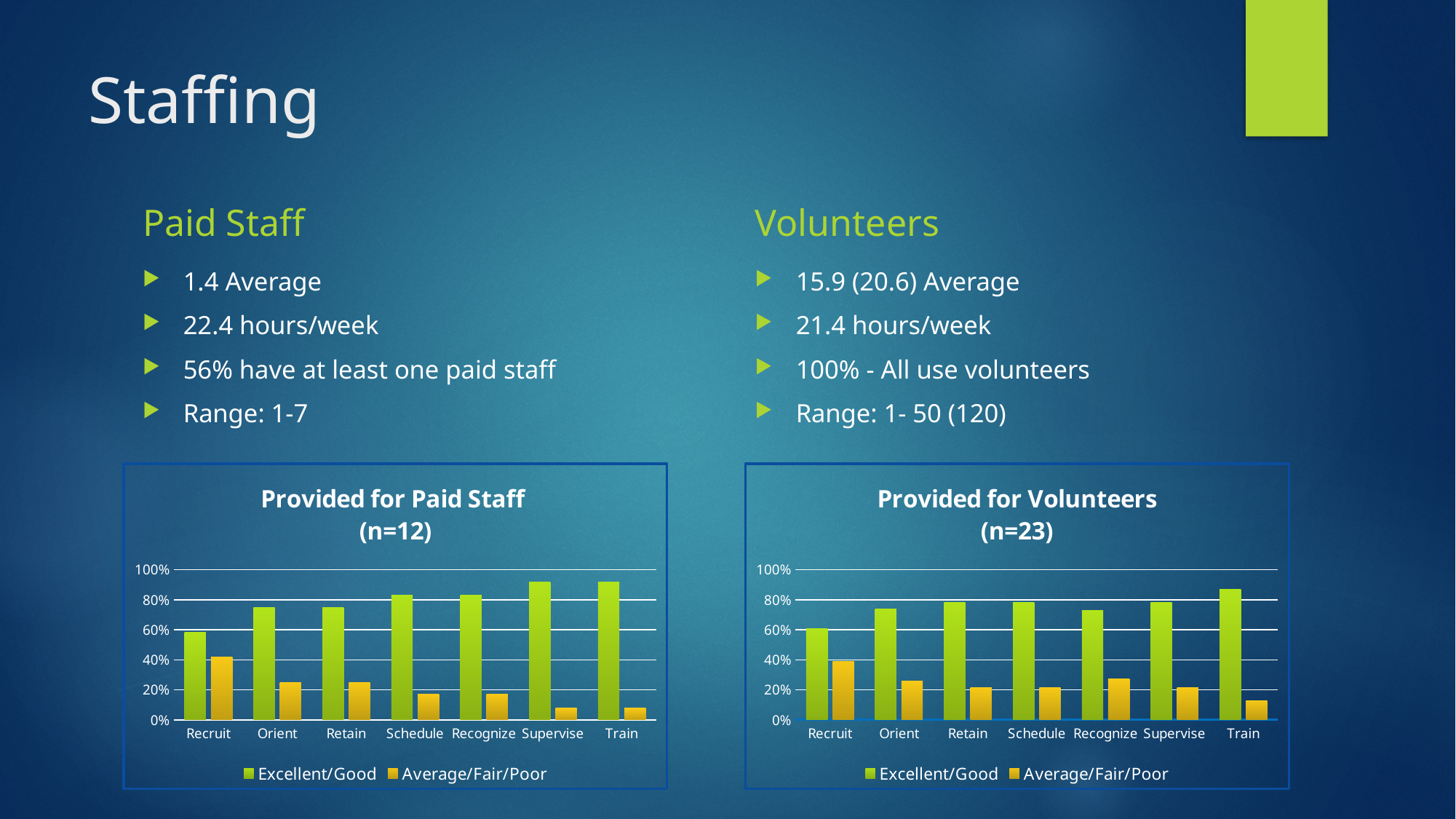
How many categories are shown on the x axis of the "Provided for Volunteers (n=23)" chart? 7 What sample size is given in the title of the "Provided for Volunteers" chart? n=23 In the "Provided for Paid Staff (n=12)" chart, is the Excellent/Good value for Supervise greater or less than 80%? greater In the "Provided for Volunteers (n=23)" chart, is the Average/Fair/Poor value for Train greater or less than 20%? less In the "Provided for Volunteers (n=23)" chart, which category has the highest Excellent/Good value? Train In the "Provided for Volunteers (n=23)" chart, which category has the highest Average/Fair/Poor value? Recruit In the "Provided for Paid Staff (n=12)" chart, is the Average/Fair/Poor value for Train greater or less than 20%? less In the "Provided for Paid Staff (n=12)" chart, which is larger for Recruit: the Excellent/Good value or the Average/Fair/Poor value? Excellent/Good In the "Provided for Paid Staff (n=12)" chart, which category has the lowest Excellent/Good value? Recruit What kind of chart is the "Provided for Paid Staff (n=12)" chart? bar chart How many series does the legend of the "Provided for Paid Staff (n=12)" chart list? 2